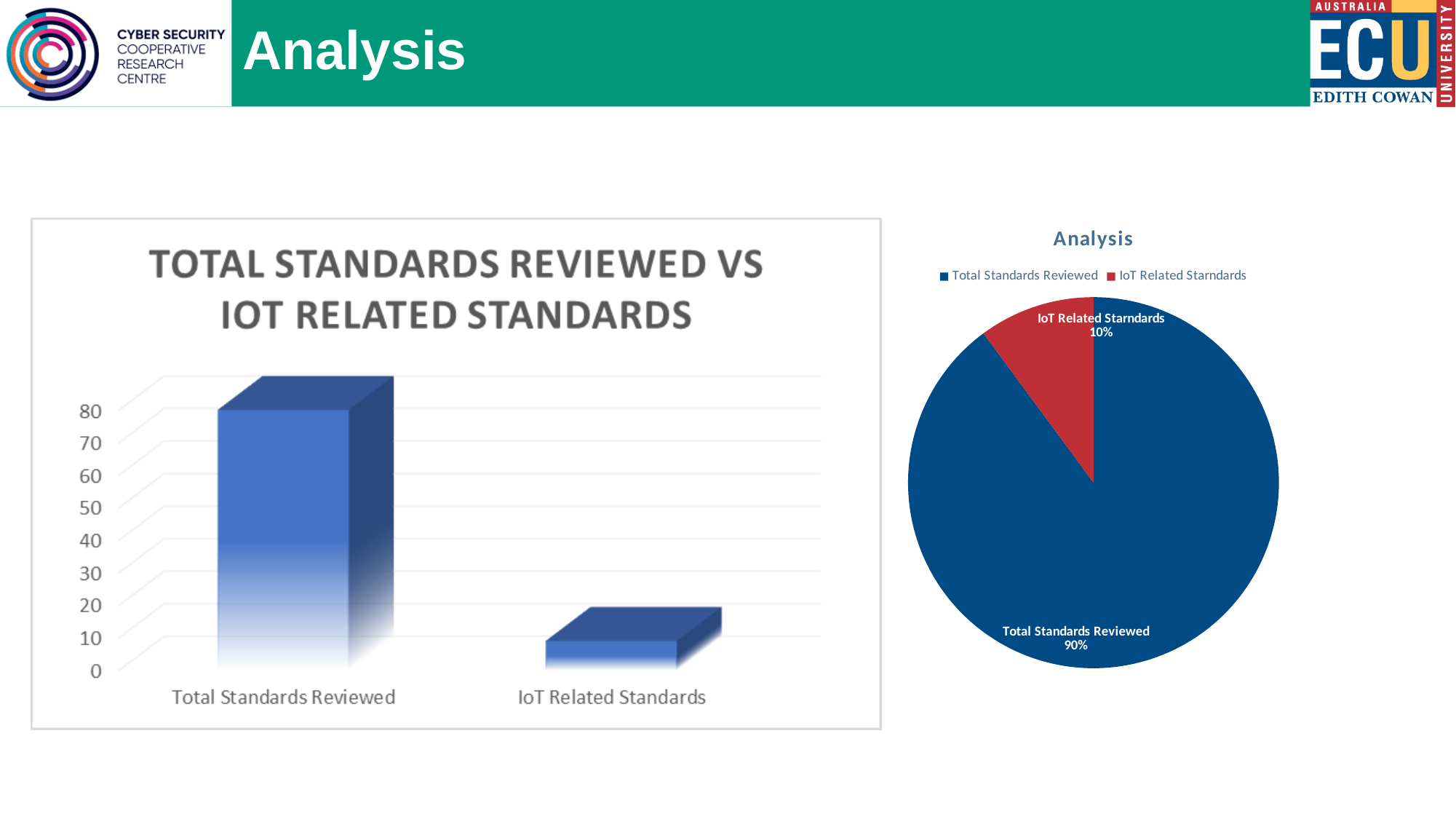
In the pie chart titled "Analysis", which slice is the largest? Total Standards Reviewed What kind of chart is the chart titled "TOTAL STANDARDS REVIEWED VS IOT RELATED STANDARDS"? Bar chart In the pie chart titled "Analysis", what share does Total Standards Reviewed have? 90% In the pie chart titled "Analysis", how many entries does the legend list? 2 In the bar chart titled "TOTAL STANDARDS REVIEWED VS IOT RELATED STANDARDS", which category has the taller bar? Total Standards Reviewed In the bar chart titled "TOTAL STANDARDS REVIEWED VS IOT RELATED STANDARDS", how many categories are shown? 2 In the bar chart titled "TOTAL STANDARDS REVIEWED VS IOT RELATED STANDARDS", is the value for IoT Related Standards greater or less than 20? less In the pie chart titled "Analysis", which slice is the smallest? IoT Related Starndards In the pie chart titled "Analysis", by how many percentage points does Total Standards Reviewed exceed IoT Related Starndards? 80 percentage points What kind of chart is the chart on the right of the slide? Pie chart In the bar chart titled "TOTAL STANDARDS REVIEWED VS IOT RELATED STANDARDS", is the value for Total Standards Reviewed greater or less than 70? greater In the pie chart titled "Analysis", what share does IoT Related Starndards have? 10%